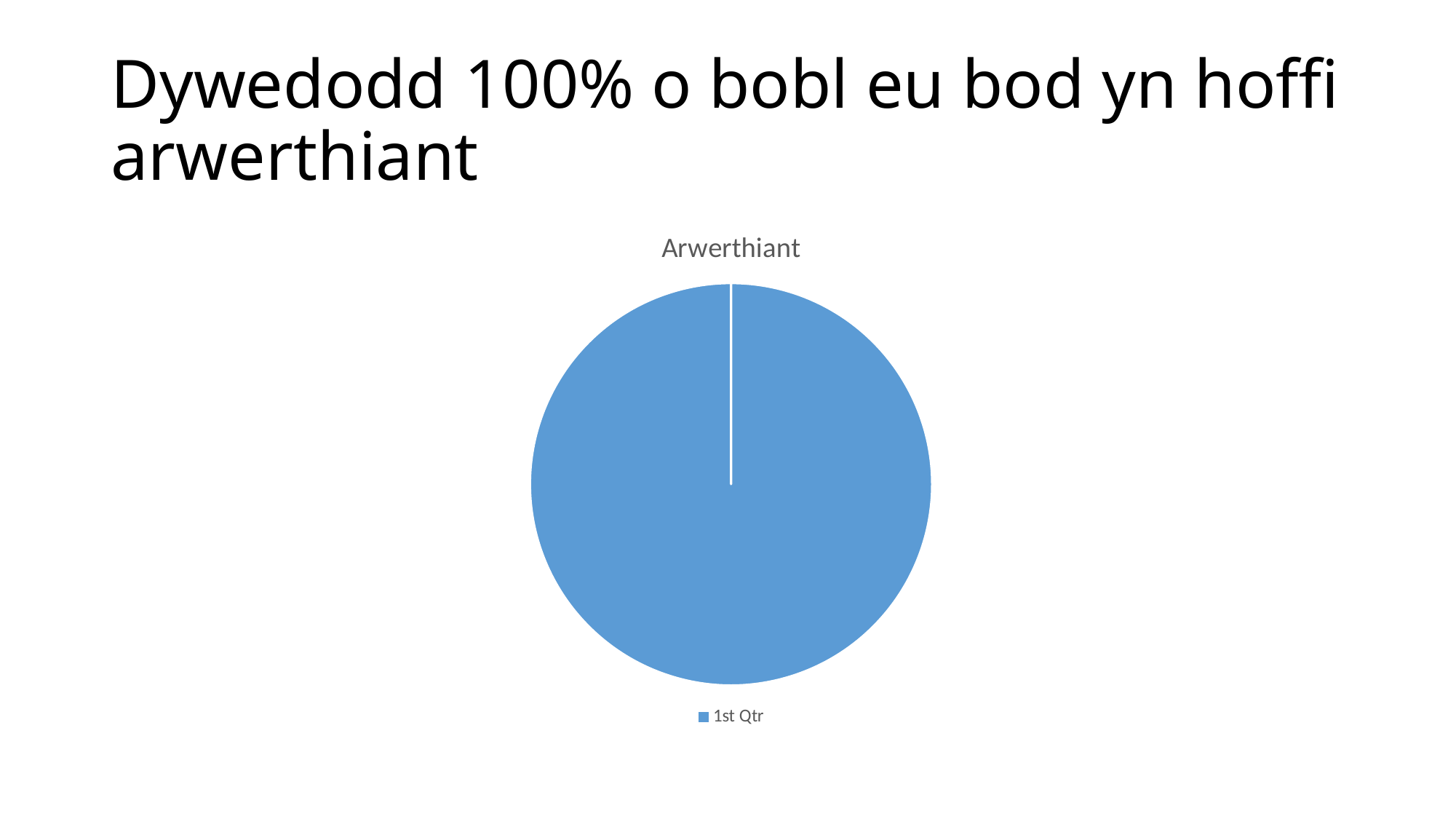
What is the title of the chart? Arwerthiant How many entries does the chart's legend list? 1 What kind of chart is shown on the slide? pie chart What colour is the 1st Qtr slice in the pie chart? blue How many slices does the pie chart have? 1 Which slice is the largest in the pie chart? 1st Qtr What share of the pie does the 1st Qtr slice take up? 100% What is the label of the only slice in the pie chart? 1st Qtr